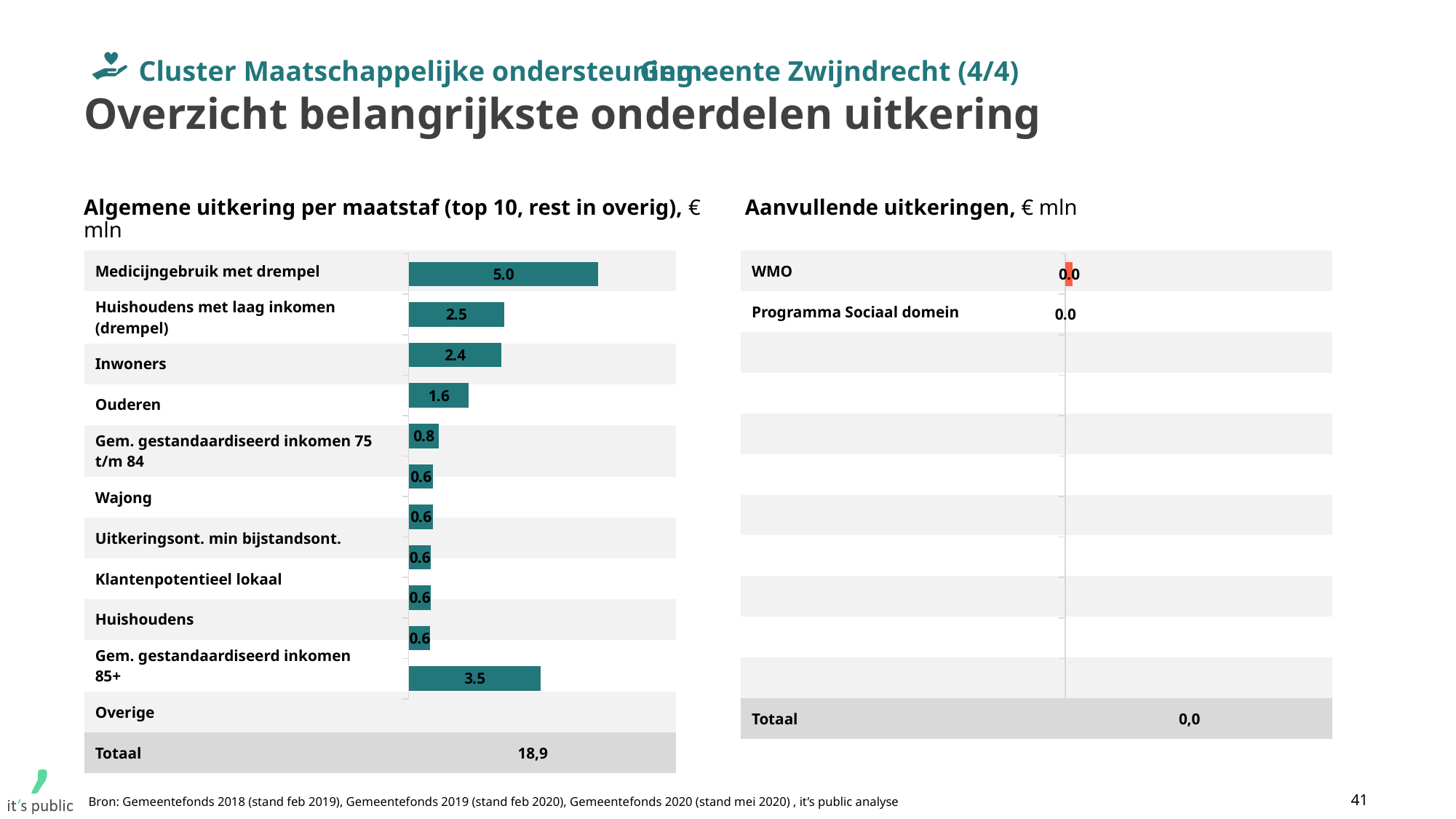
In the chart 'Aanvullende uitkeringen', what is the Totaal? 0,0 In the chart 'Algemene uitkering per maatstaf', which is larger: Ouderen or Gem. gestandaardiseerd inkomen 75 t/m 84? Ouderen What type of chart is 'Algemene uitkering per maatstaf'? Bar chart In the chart 'Algemene uitkering per maatstaf', what is the value for Ouderen? 1.6 In the chart 'Algemene uitkering per maatstaf', what is the value for Inwoners? 2.4 In the chart 'Algemene uitkering per maatstaf', what is the value for Medicijngebruik met drempel? 5.0 How many categories (bars) are shown in the chart 'Algemene uitkering per maatstaf'? 11 In the chart 'Algemene uitkering per maatstaf', what is the value for Overige? 3.5 In the chart 'Algemene uitkering per maatstaf', what is the difference between Medicijngebruik met drempel and Huishoudens met laag inkomen (drempel)? 2.5 In the chart 'Aanvullende uitkeringen', what is the value for WMO? 0.0 In the chart 'Algemene uitkering per maatstaf', what is the Totaal shown at the bottom? 18,9 In the chart 'Algemene uitkering per maatstaf', which category has the highest value? Medicijngebruik met drempel